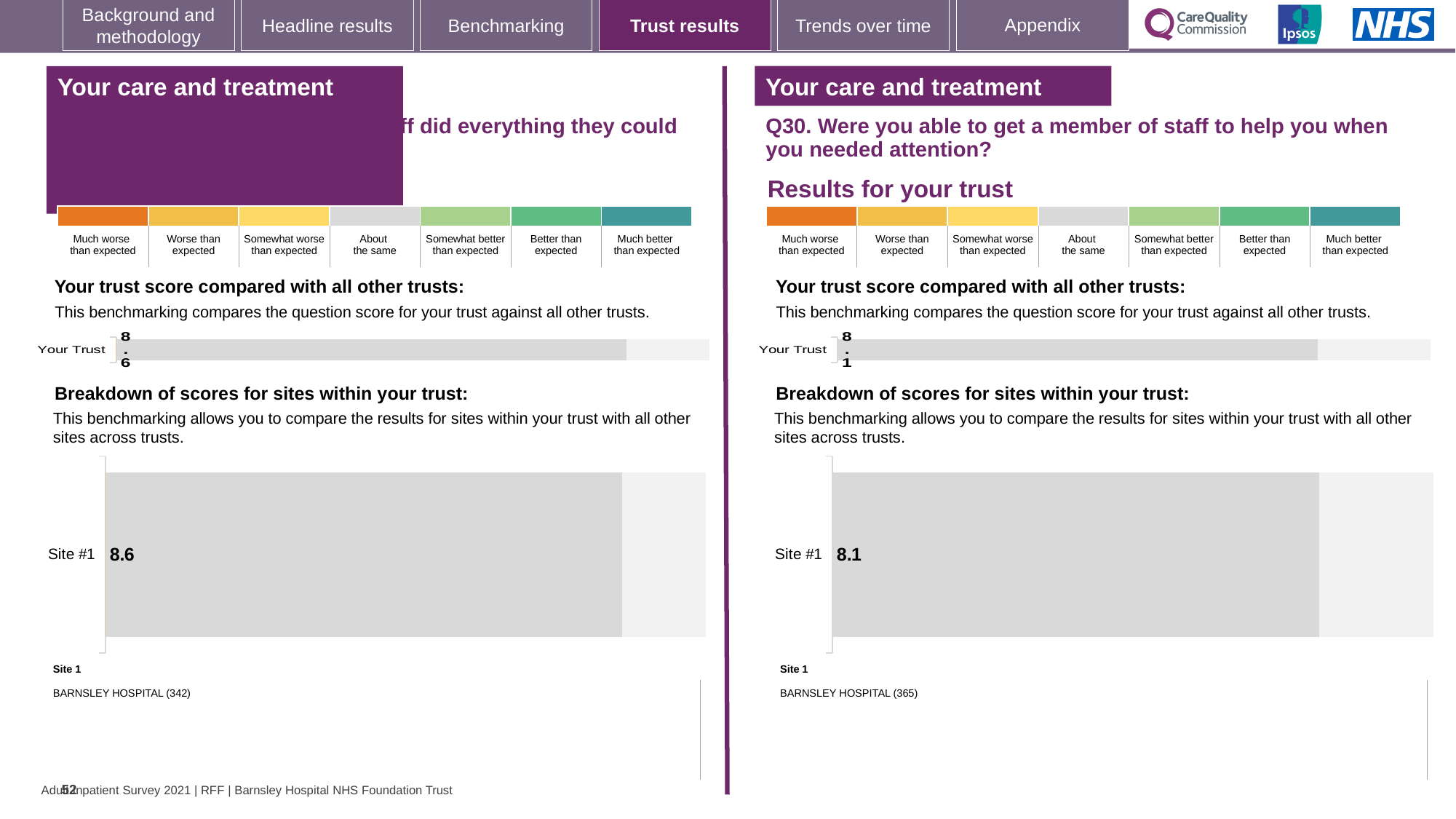
On the right-hand chart for Q30, what is the 'Your Trust' score shown? 8.1 How many sites are shown in the right-hand 'Breakdown of scores for sites within your trust' chart for Q30? 1 What is the difference between the 'Your Trust' score on the left-hand chart (8.6) and the 'Your Trust' score on the right-hand Q30 chart (8.1)? 0.5 How many sites are shown in the left-hand 'Breakdown of scores for sites within your trust' chart? 1 On the left-hand breakdown chart, which hospital is listed as Site 1? BARNSLEY HOSPITAL (342) On the right-hand Q30 breakdown chart, which hospital is listed as Site 1? BARNSLEY HOSPITAL (365) On the left-hand 'Your trust score compared with all other trusts' chart, what is the 'Your Trust' score shown? 8.6 On the left-hand 'Breakdown of scores for sites within your trust' chart, what is the score for Site #1? 8.6 On the right-hand 'Breakdown of scores for sites within your trust' chart for Q30, what is the score for Site #1? 8.1 What type of chart is used for the Site #1 score in the left-hand breakdown section? Bar chart Which is larger: the Site #1 score on the left-hand breakdown chart or the Site #1 score on the right-hand breakdown chart for Q30? Left-hand chart (8.6) What type of chart is used for the 'Your Trust' score on the right-hand Q30 section? Bar chart